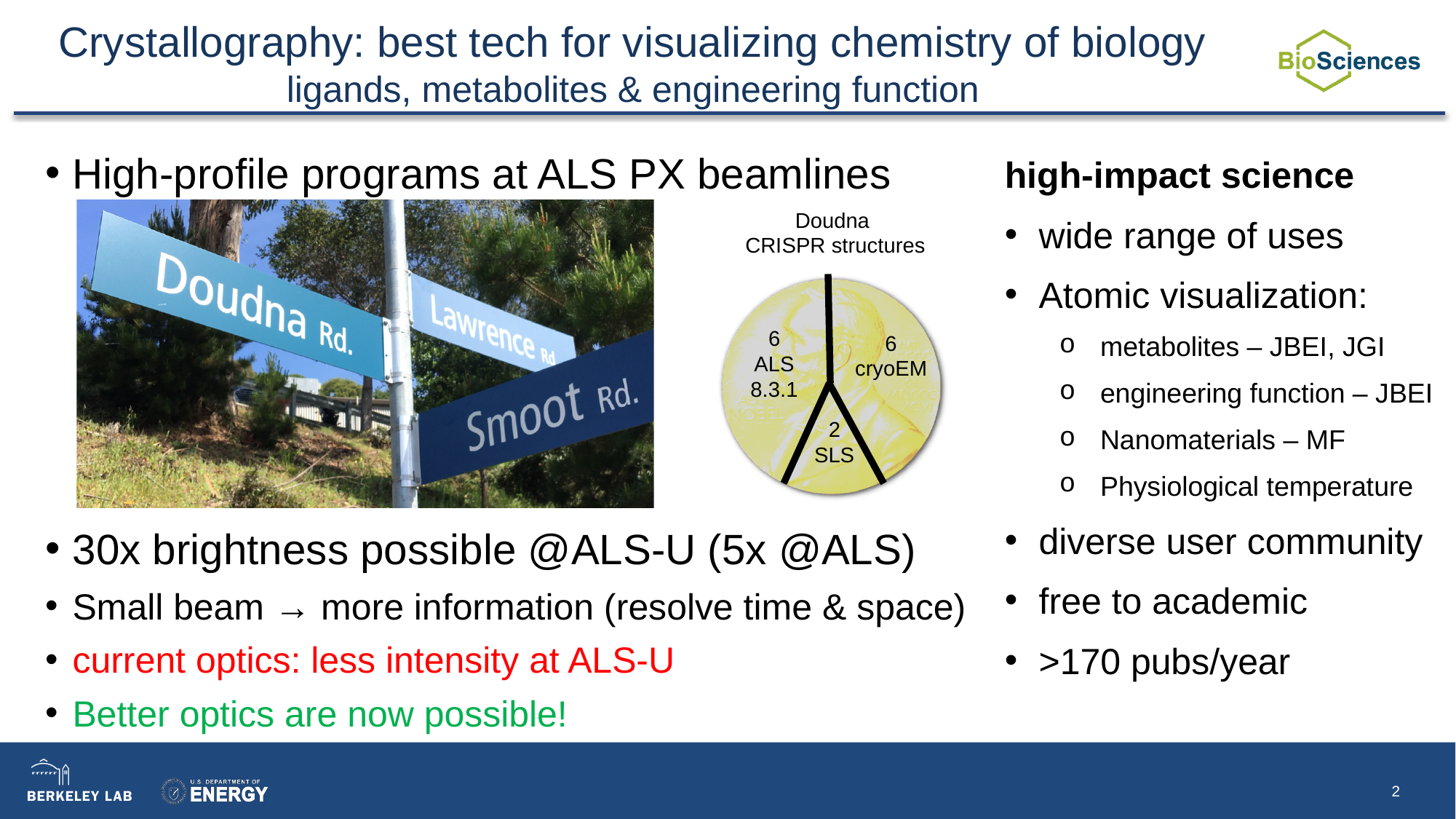
How many slices does the Doudna CRISPR structures pie chart have? 3 What is the title of the pie chart on the slide? Doudna CRISPR structures In the Doudna CRISPR structures pie chart, what is the value for cryoEM? 6 In the Doudna CRISPR structures pie chart, what is the value for SLS? 2 What is the total of all slices in the Doudna CRISPR structures pie chart? 14 Which two slices of the Doudna CRISPR structures pie chart have equal values? ALS 8.3.1 and cryoEM In the Doudna CRISPR structures pie chart, which is larger: ALS 8.3.1 or SLS? ALS 8.3.1 In the Doudna CRISPR structures pie chart, what fraction of the total do the SLS structures represent? 2 of 14 (1/7) What kind of chart is shown under the heading "Doudna CRISPR structures"? pie chart In the Doudna CRISPR structures pie chart, what is the difference between the cryoEM value and the SLS value? 4 Which slice of the Doudna CRISPR structures pie chart has the smallest value? SLS In the Doudna CRISPR structures pie chart, what is the value for ALS 8.3.1? 6